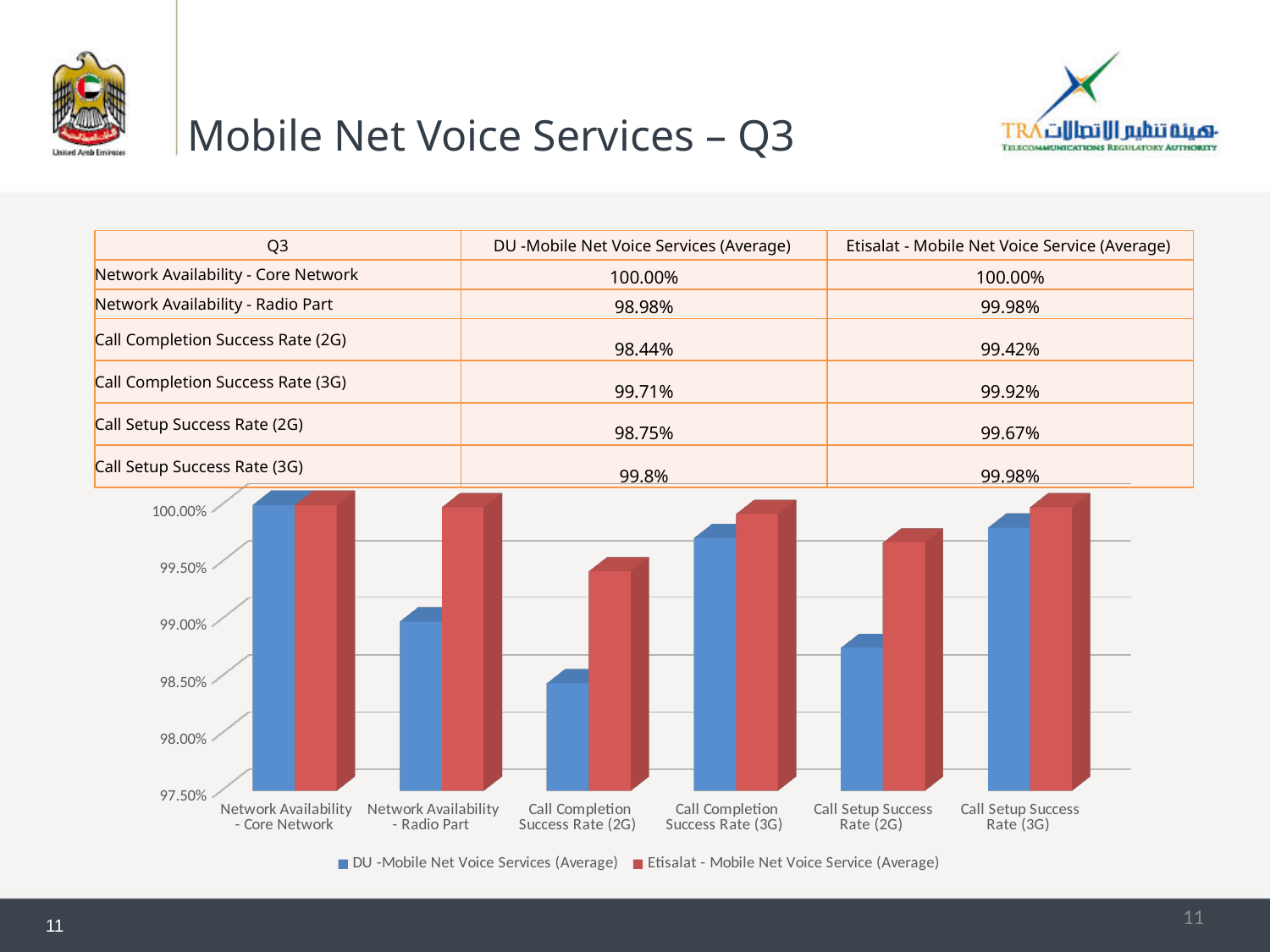
What is the Etisalat value for Network Availability - Radio Part? 99.98% What is the difference between the Etisalat and DU values for Network Availability - Radio Part? 1.00% How many categories are shown on the x axis of the chart? 6 What is the Etisalat value for Call Setup Success Rate (2G)? 99.67% Which category has the lowest DU value? Call Completion Success Rate (2G) For Call Completion Success Rate (3G), which is larger, the DU value or the Etisalat value? Etisalat How many series does the chart legend list? 2 What kind of chart is shown on the slide? bar chart Is the DU value for Call Setup Success Rate (2G) greater or less than 99.00%? less Which category has the lowest Etisalat value? Call Completion Success Rate (2G) What is the DU value for Call Completion Success Rate (2G)? 98.44% What is the DU value for Call Setup Success Rate (3G)? 99.8%